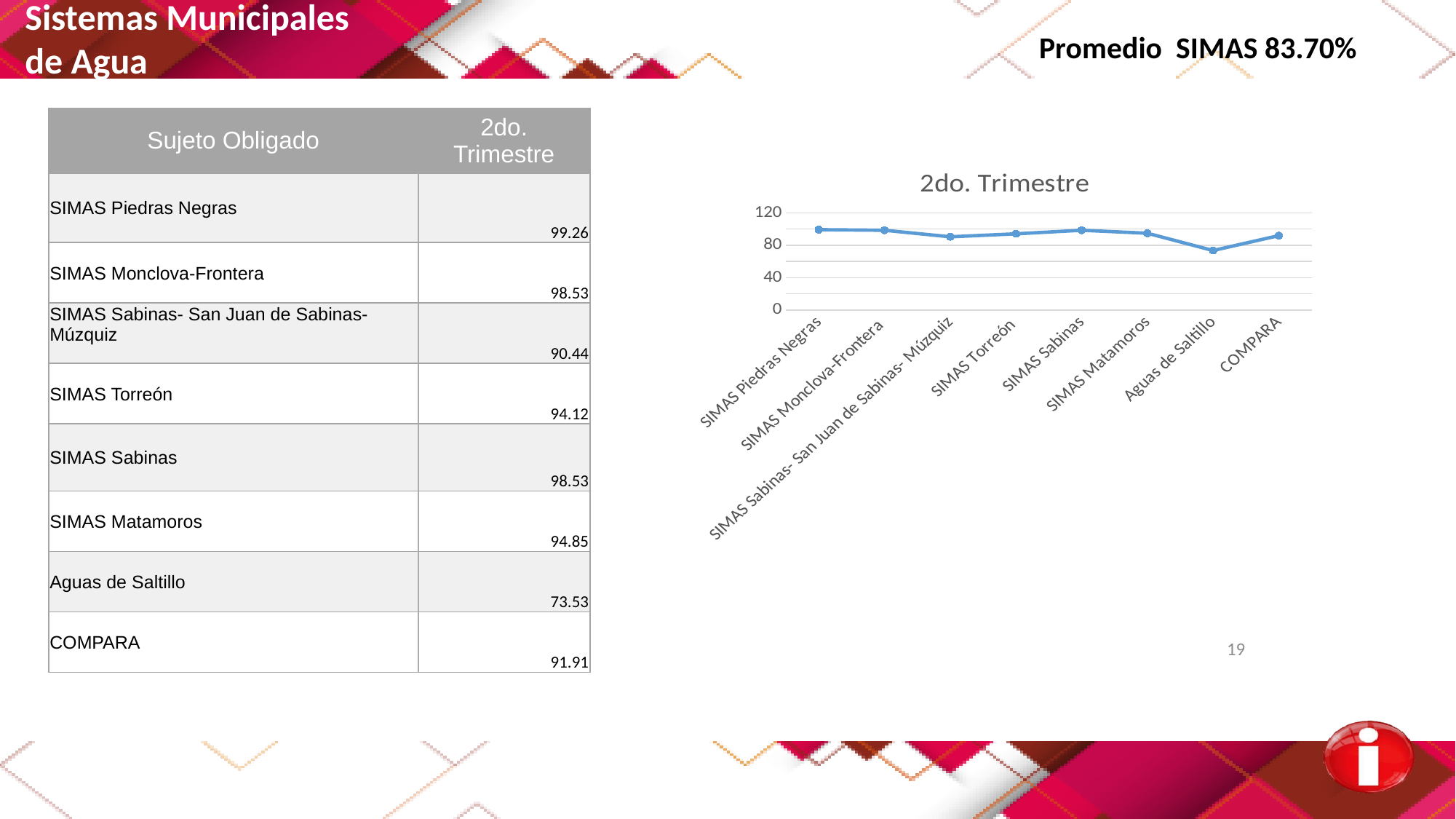
What is the title of the chart? 2do. Trimestre How many categories are plotted along the x axis of the chart? 8 Which is larger, the value for SIMAS Torreón or the value for Aguas de Saltillo? SIMAS Torreón Does the line rise or fall from SIMAS Matamoros to Aguas de Saltillo? fall Is the value for Aguas de Saltillo greater or less than 80? less What kind of chart is shown on the slide? line chart What is the 2do. Trimestre value for SIMAS Torreón? 94.12 What is the 2do. Trimestre value for SIMAS Matamoros? 94.85 Which category has the lowest value in the chart? Aguas de Saltillo What is the 2do. Trimestre value for COMPARA? 91.91 What is the difference between the values for SIMAS Piedras Negras and Aguas de Saltillo? 25.73 Is the value for SIMAS Piedras Negras greater or less than 80? greater